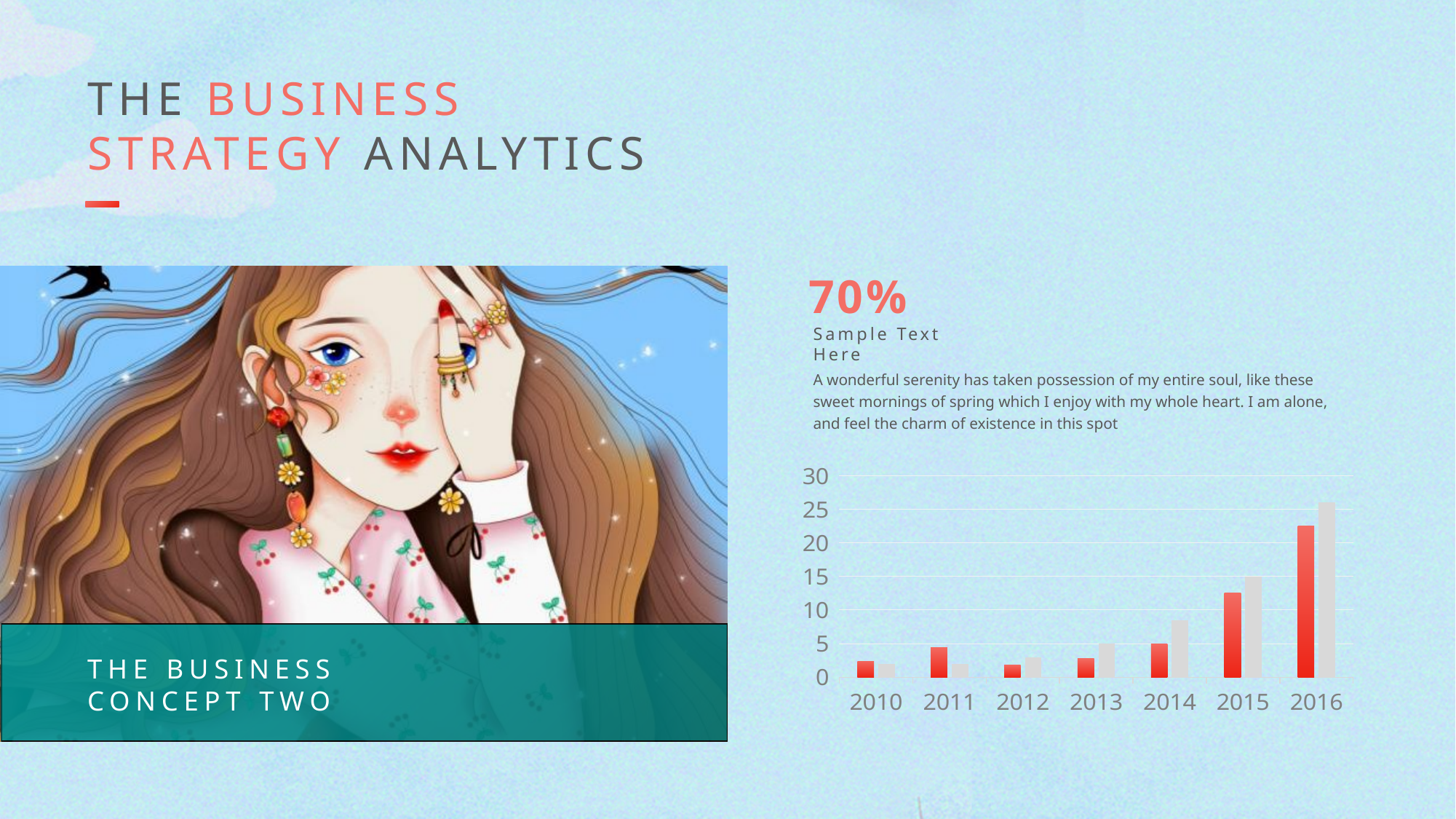
What kind of chart is shown on the slide? bar chart Is the grey bar for 2014 greater or less than 10? less Which year has the tallest grey bar in the chart? 2016 Is the red bar for 2015 greater or less than 10? greater Which year has the tallest red bar in the chart? 2016 Is the red bar for 2010 greater or less than 5? less Do the grey bars generally rise or fall from 2012 to 2016? rise What is the highest value shown on the chart's y axis? 30 In 2016, which bar is taller, the red bar or the grey bar? the grey bar How many years are shown on the x axis of the chart? 7